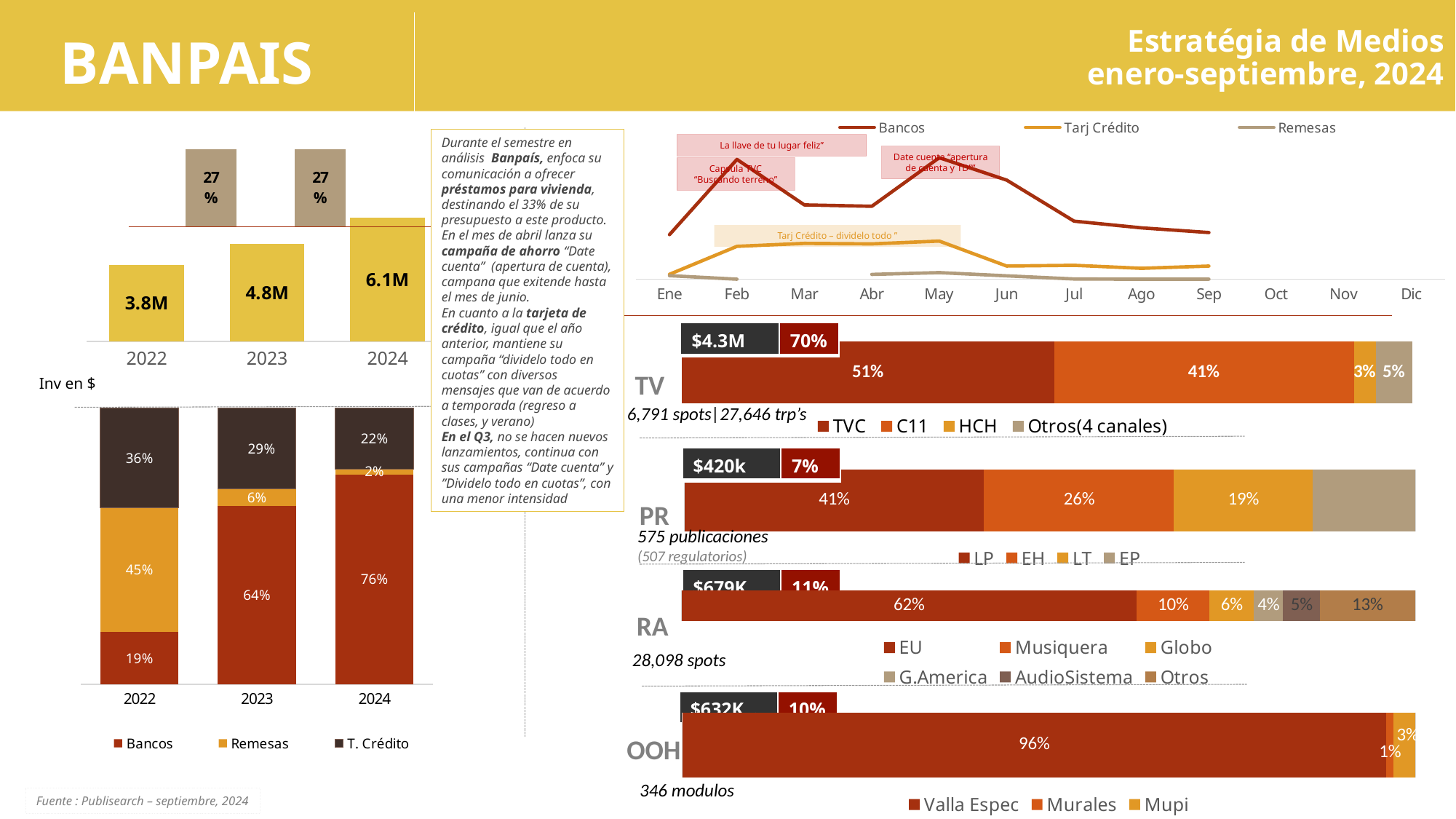
In the line chart at the top right, how many months are shown on the x axis? 12 In the stacked bar chart at the bottom left, how many series does the legend list? 3 In the RA bar on the right, which channel has the highest share? EU In the stacked bar chart at the bottom left, what is the share for Bancos in 2024? 76% In the 'Inv en $' bar chart on the left, which year has the lowest investment? 2022 In the 'Inv en $' bar chart on the left, what is the value for 2024? 6.1M In the stacked bar chart at the bottom left, is the T. Crédito share larger in 2022 or in 2024? 2022 In the line chart at the top right, which series is drawn in dark red? Bancos In the OOH bar on the right, what is the share for Valla Espec? 96% In the stacked bar chart at the bottom left, what is the share for Remesas in 2022? 45% In the 'Inv en $' bar chart on the left, what is the difference between the 2023 and 2022 values? 1.0M In the TV bar on the right, what is the share for C11? 41%